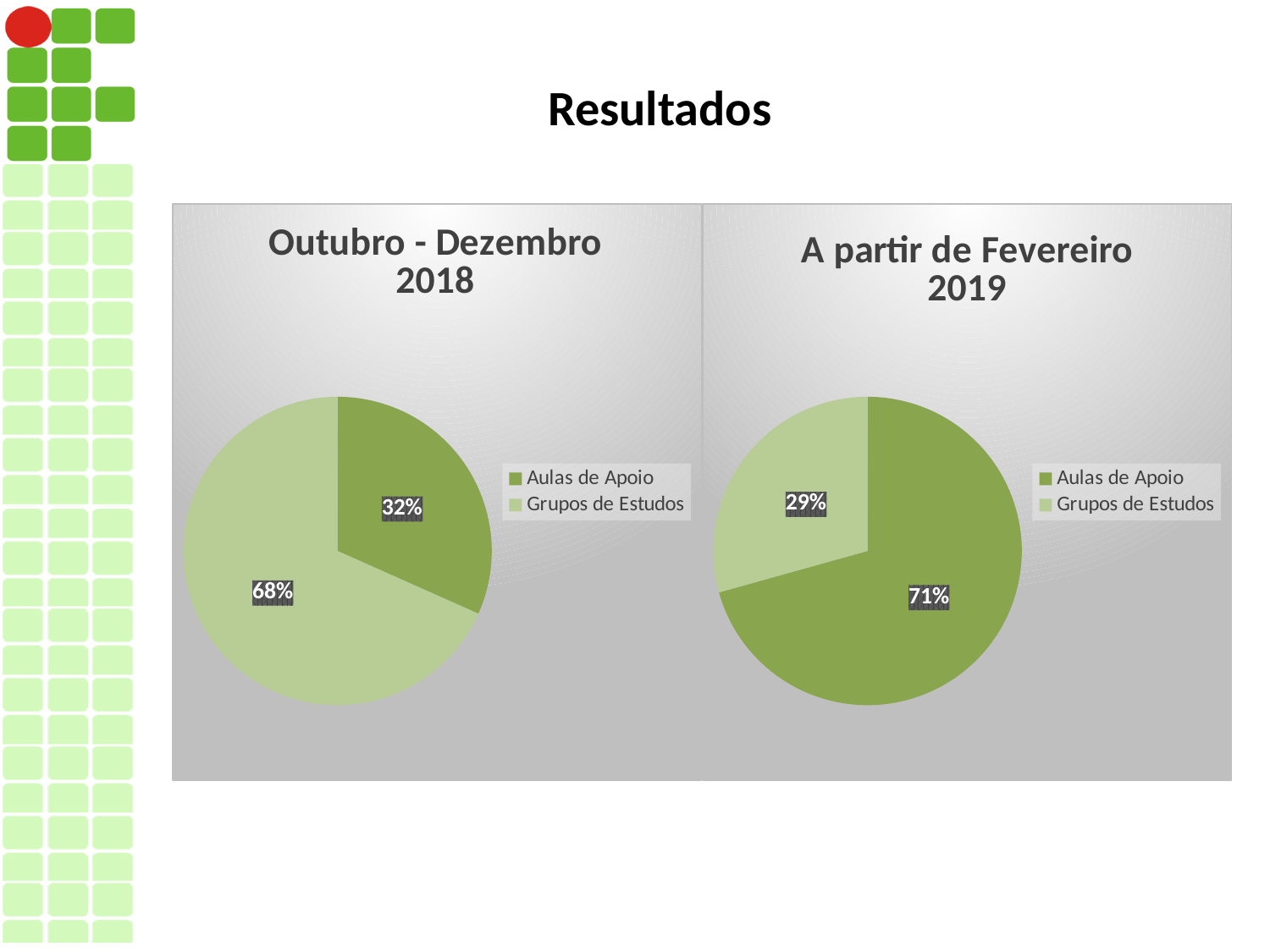
In the 'A partir de Fevereiro 2019' chart, what is the difference between the Aulas de Apoio and Grupos de Estudos shares? 42% How many categories does the 'A partir de Fevereiro 2019' chart show? 2 In the 'Outubro - Dezembro 2018' chart, what is the difference between the Grupos de Estudos and Aulas de Apoio shares? 36% In the 'Outubro - Dezembro 2018' chart, what share does Grupos de Estudos have? 68% In the 'Outubro - Dezembro 2018' chart, what share does Aulas de Apoio have? 32% In the 'A partir de Fevereiro 2019' chart, what share does Grupos de Estudos have? 29% In the 'A partir de Fevereiro 2019' chart, which category has the smallest slice? Grupos de Estudos What is the title of the chart on the right side of the slide? A partir de Fevereiro 2019 What type of chart is the 'Outubro - Dezembro 2018' chart? Pie chart In the 'Outubro - Dezembro 2018' chart, which category has the largest slice? Grupos de Estudos In the 'A partir de Fevereiro 2019' chart, which is larger: Aulas de Apoio or Grupos de Estudos? Aulas de Apoio